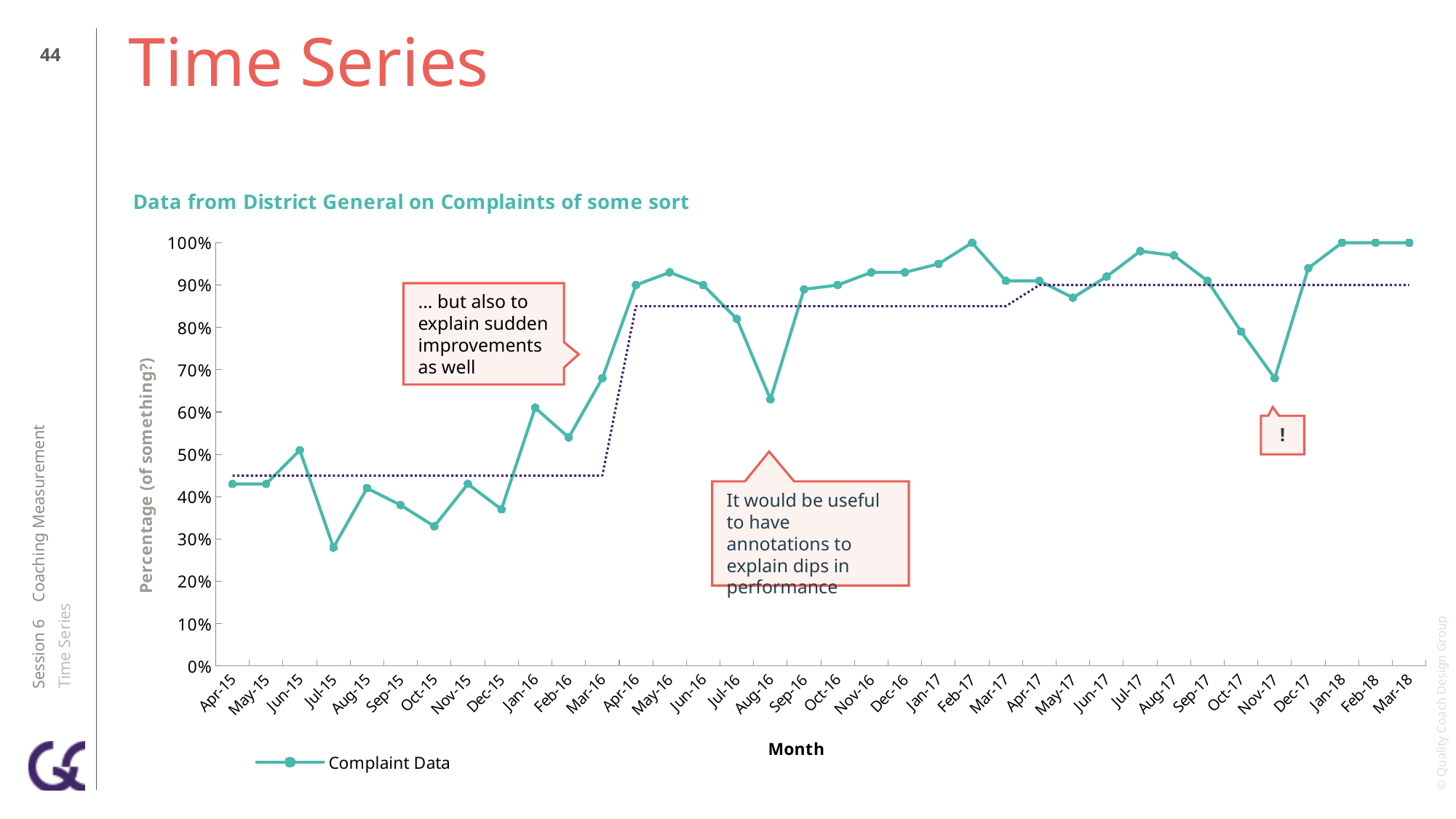
What kind of chart is shown on the slide? Line chart What is the title of the chart? Data from District General on Complaints of some sort What is the value for Complaint Data in Feb-17? 100% Is the value for Complaint Data in Aug-16 greater or less than 70%? less How many series does the legend list? 1 Is the value for Complaint Data in Jul-15 greater or less than 40%? less What is the value for Complaint Data in Mar-18? 100% What is the name of the series shown in the legend? Complaint Data Which is larger, the value for Jun-15 or the value for Jul-15? Jun-15 Which month has the lowest value for Complaint Data? Jul-15 Overall, do the Complaint Data values rise or fall from Apr-15 to Mar-18? Rise How many months are plotted along the x axis? 36